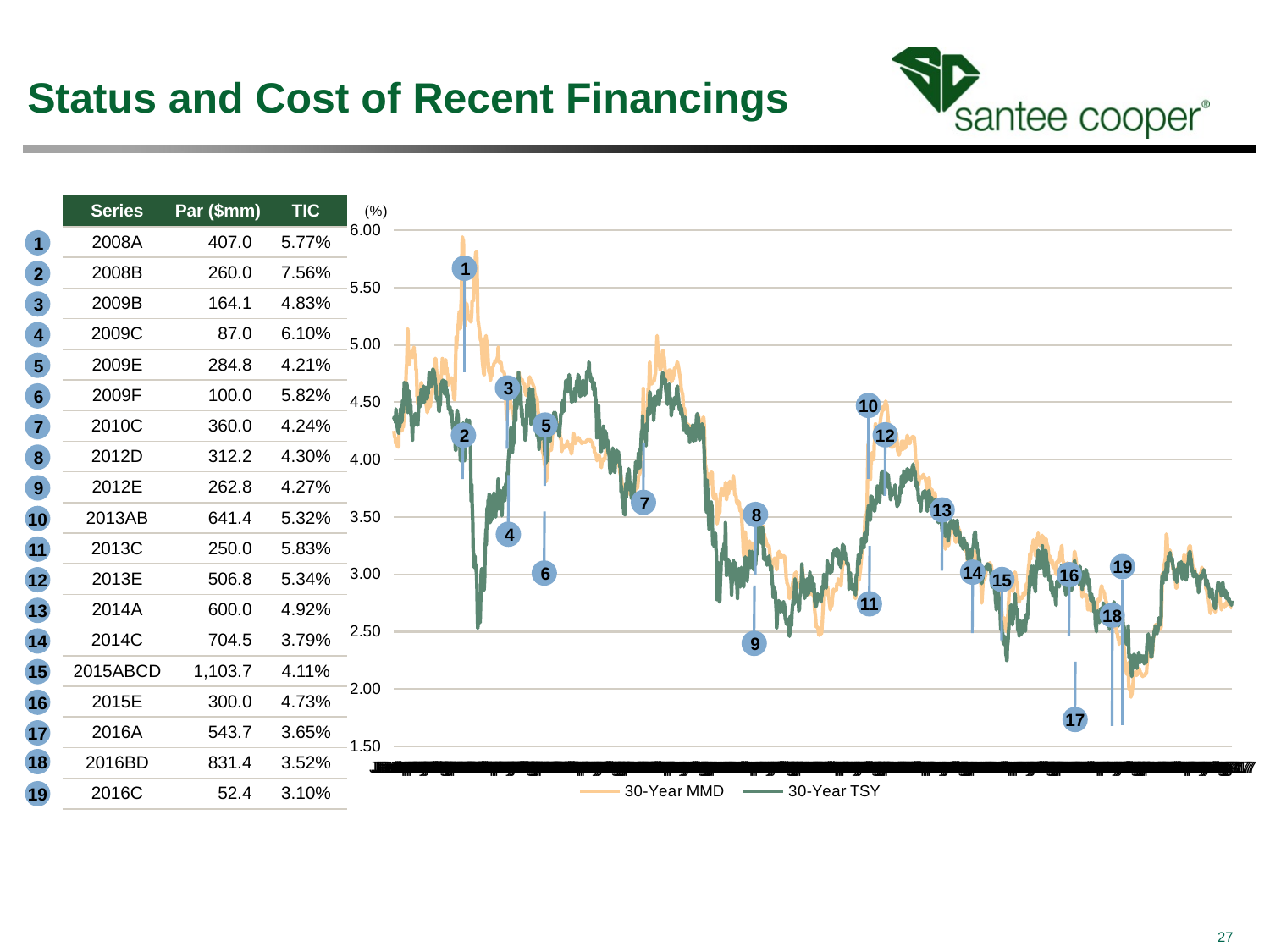
Is the peak value reached by the 30-Year MMD line near marker 1 greater or less than 5.50? greater What is the lowest value shown on the chart's vertical axis? 1.50 How many series does the chart legend list? 2 What kind of chart is shown on the slide? Line chart Is the value of the 30-Year MMD line at the far right end of the chart greater or less than 3.00? less Which series is drawn in the dark green line? 30-Year TSY Is the lowest value reached by the 30-Year TSY line near marker 18 greater or less than 2.50? less What is the highest value shown on the chart's vertical axis? 6.00 What are the two series named in the chart legend? 30-Year MMD and 30-Year TSY Overall, do the lines on the chart rise or fall from left to right? Fall How many numbered markers are placed on the chart? 19 What unit is indicated at the top of the chart's vertical axis? (%)